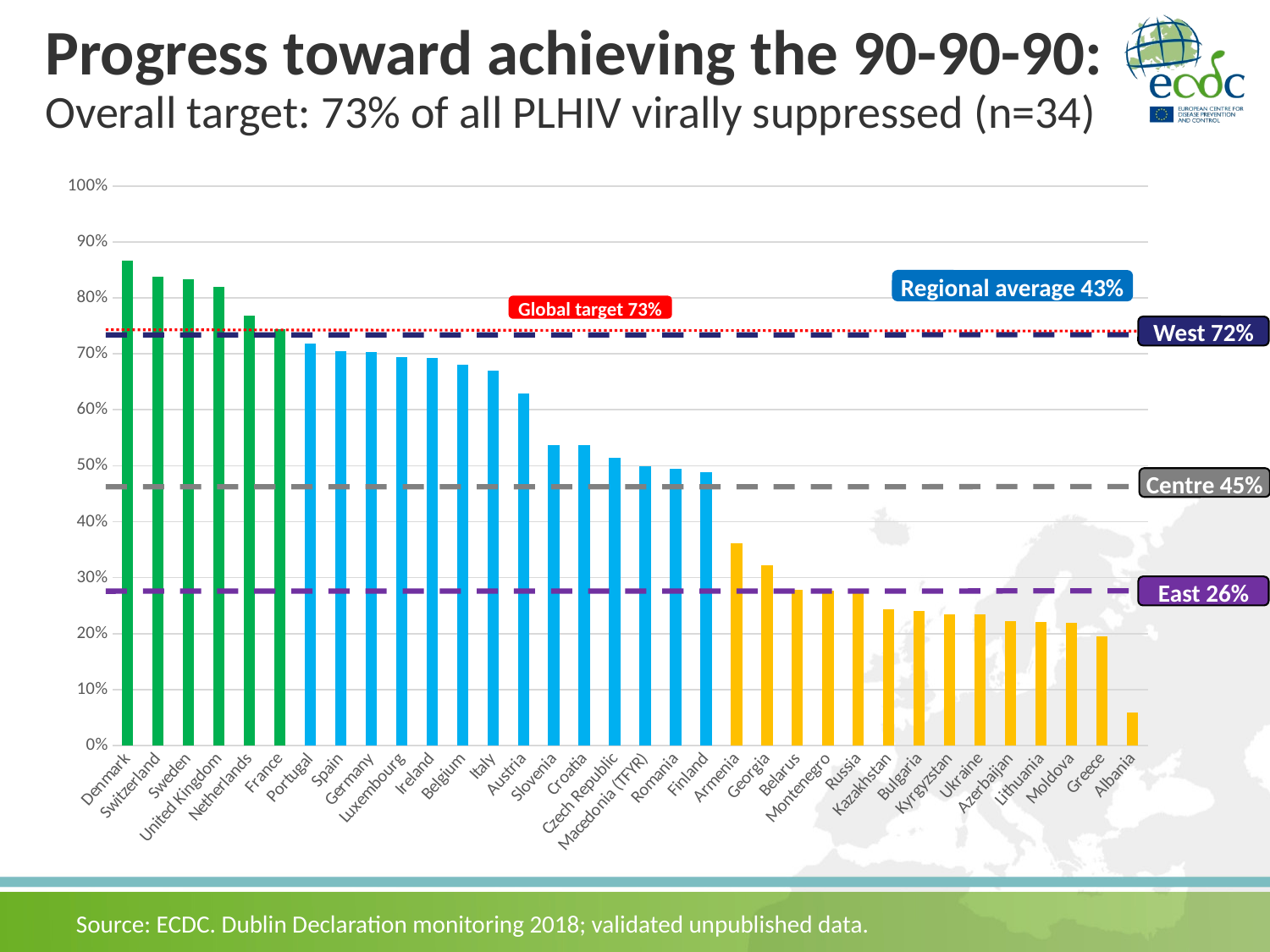
Do the bar values rise or fall moving from left to right along the x axis? Fall Is the value for Albania greater or less than 10%? less Which country has the lowest percentage of PLHIV virally suppressed? Albania How many countries are plotted in the chart? 34 Which has a higher value, Portugal or Armenia? Portugal What value is shown for the Global target line? 73% What kind of chart is shown on the slide? Bar chart Is the value for Denmark greater or less than 80%? greater Is the value for Austria greater or less than 60%? greater Which country has the highest percentage of PLHIV virally suppressed? Denmark What is the regional average shown on the chart? 43%